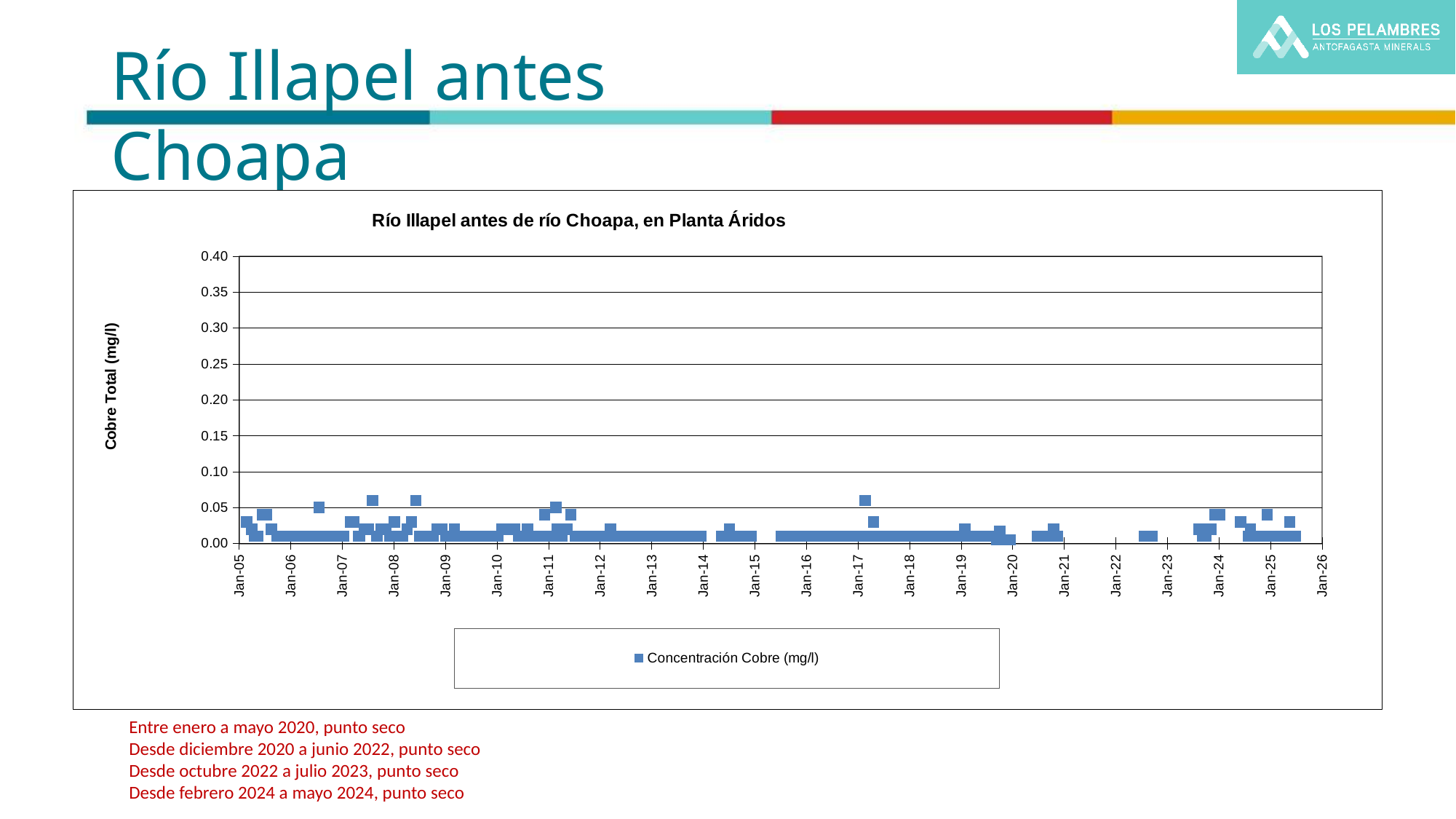
Is the highest plotted value on the chart greater or less than 0.10? less What kind of chart is shown on the slide? scatter chart What is the title of the chart? Río Illapel antes de río Choapa, en Planta Áridos Are there any points plotted between Jan-21 and Jan-22? No What is the last label on the x axis? Jan-26 What is the legend entry for the plotted series? Concentración Cobre (mg/l) How many series does the legend list? 1 What is the maximum value shown on the y axis? 0.40 How many tick labels are shown on the x axis? 22 What is the first label on the x axis? Jan-05 Is the value plotted near Jan-17 greater or less than 0.10? less Is the value plotted near Jan-13 greater or less than 0.05? less